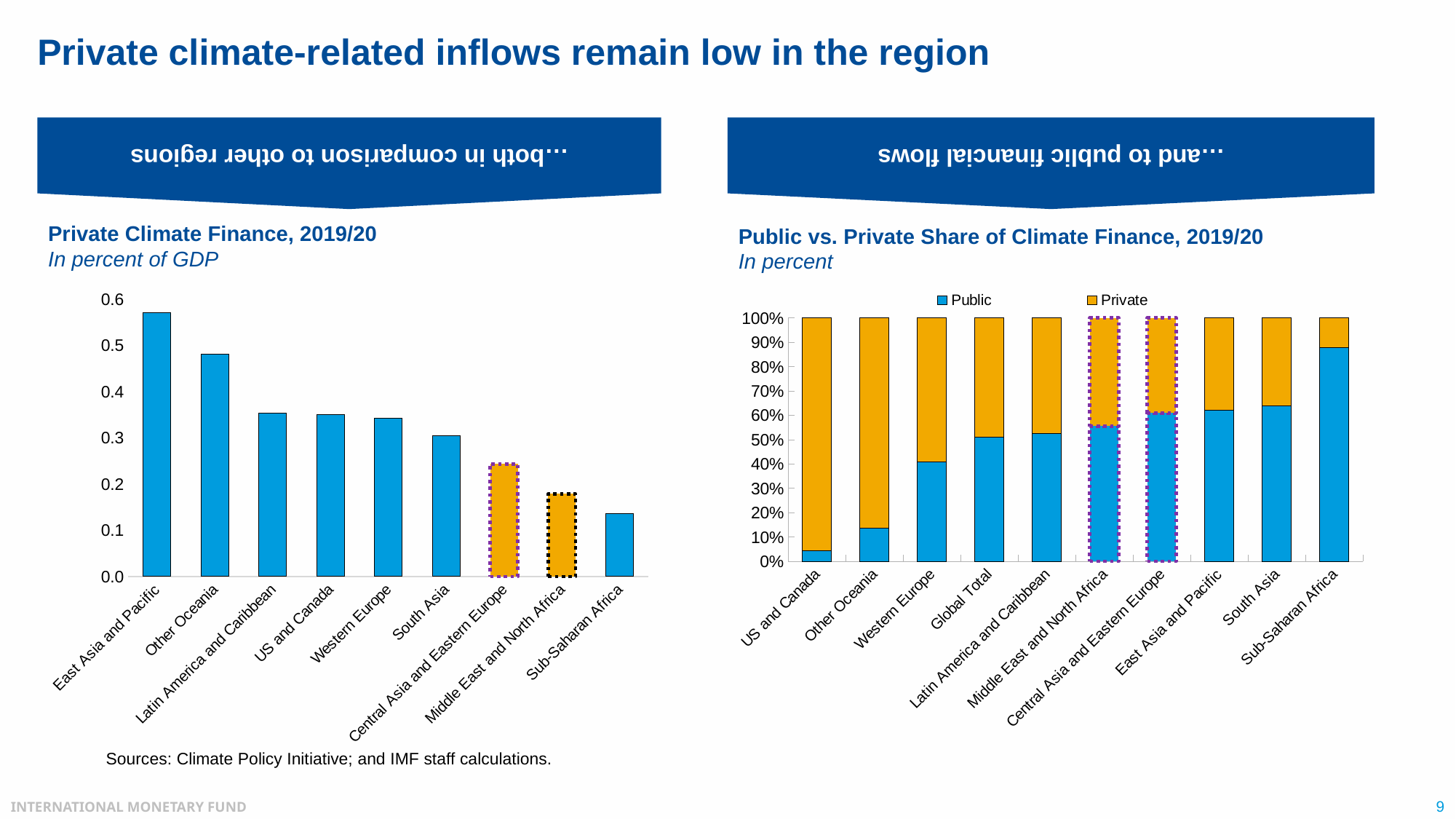
On the left chart (Private Climate Finance, 2019/20), is the value for Sub-Saharan Africa greater or less than 0.2? less On the right chart (Public vs. Private Share of Climate Finance, 2019/20), which colour represents the Private series? orange What kind of chart is the right chart (Public vs. Private Share of Climate Finance, 2019/20)? stacked bar chart On the left chart (Private Climate Finance, 2019/20), which region has the highest value? East Asia and Pacific On the right chart (Public vs. Private Share of Climate Finance, 2019/20), which region has the highest Public share? Sub-Saharan Africa On the left chart (Private Climate Finance, 2019/20), do the values rise or fall from left to right? fall On the left chart (Private Climate Finance, 2019/20), is the value for East Asia and Pacific greater or less than 0.5? greater On the right chart (Public vs. Private Share of Climate Finance, 2019/20), is the Public share for Western Europe greater or less than 50%? less On the left chart (Private Climate Finance, 2019/20), which region has the lowest value? Sub-Saharan Africa On the right chart (Public vs. Private Share of Climate Finance, 2019/20), how many series does the legend list? 2 On the left chart (Private Climate Finance, 2019/20), how many regions are shown? 9